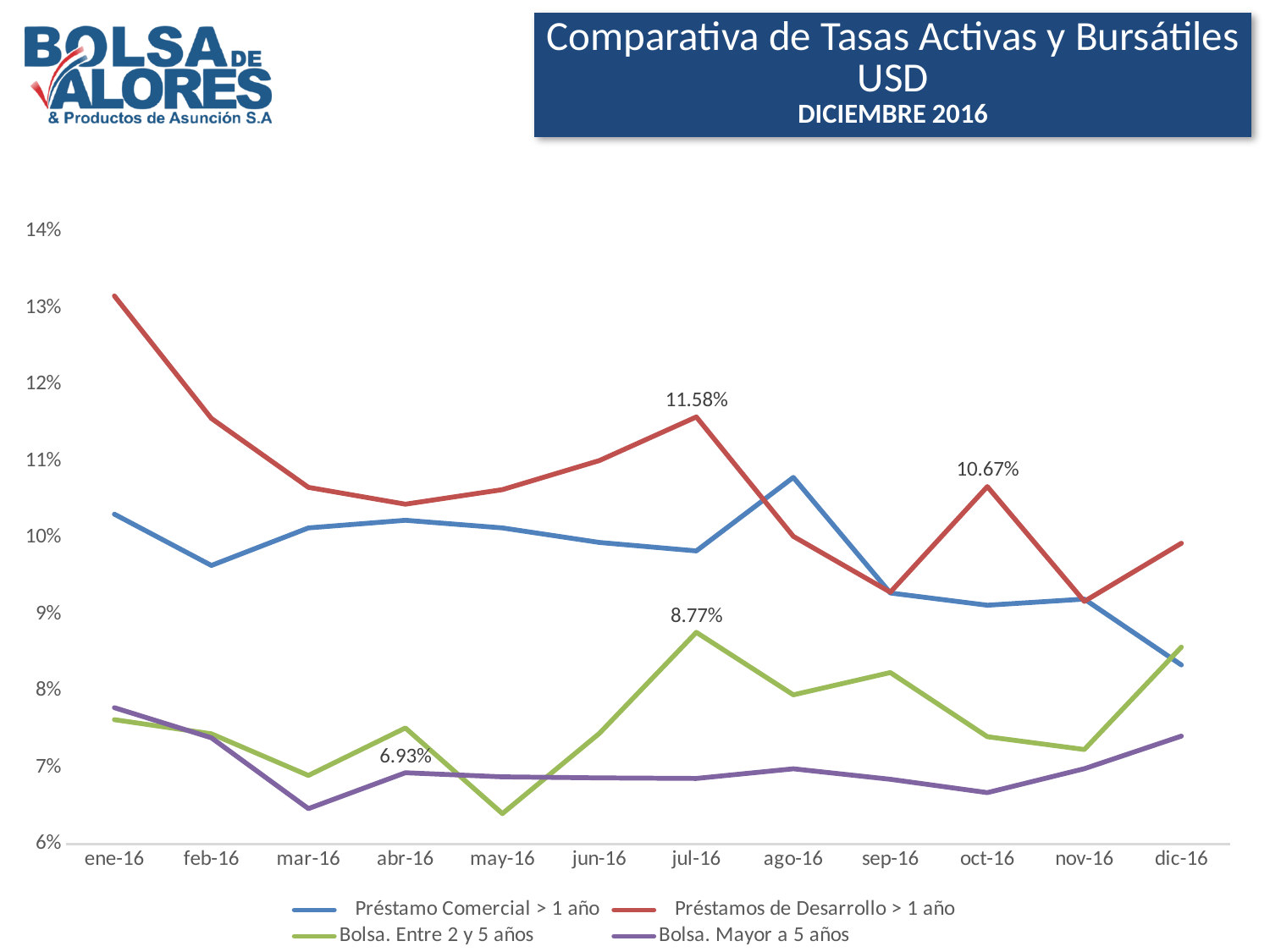
Is the value for Préstamo Comercial > 1 año in ene-16 greater or less than 10%? greater What kind of chart is shown on the slide? Line chart In ago-16, which is larger: Préstamo Comercial > 1 año or Préstamos de Desarrollo > 1 año? Préstamo Comercial > 1 año Is the value for Bolsa. Mayor a 5 años in mar-16 greater or less than 7%? less How many months are plotted along the x axis? 12 What value is labeled on the chart at abr-16? 6.93% Which series has the highest value in ene-16? Préstamos de Desarrollo > 1 año What is the difference between the jul-16 and oct-16 labeled values of Préstamos de Desarrollo > 1 año? 0.91 percentage points How many series does the legend list? 4 What is the value of Préstamos de Desarrollo > 1 año in jul-16? 11.58% What is the value of Bolsa. Entre 2 y 5 años in jul-16? 8.77% What is the value of Préstamos de Desarrollo > 1 año in oct-16? 10.67%